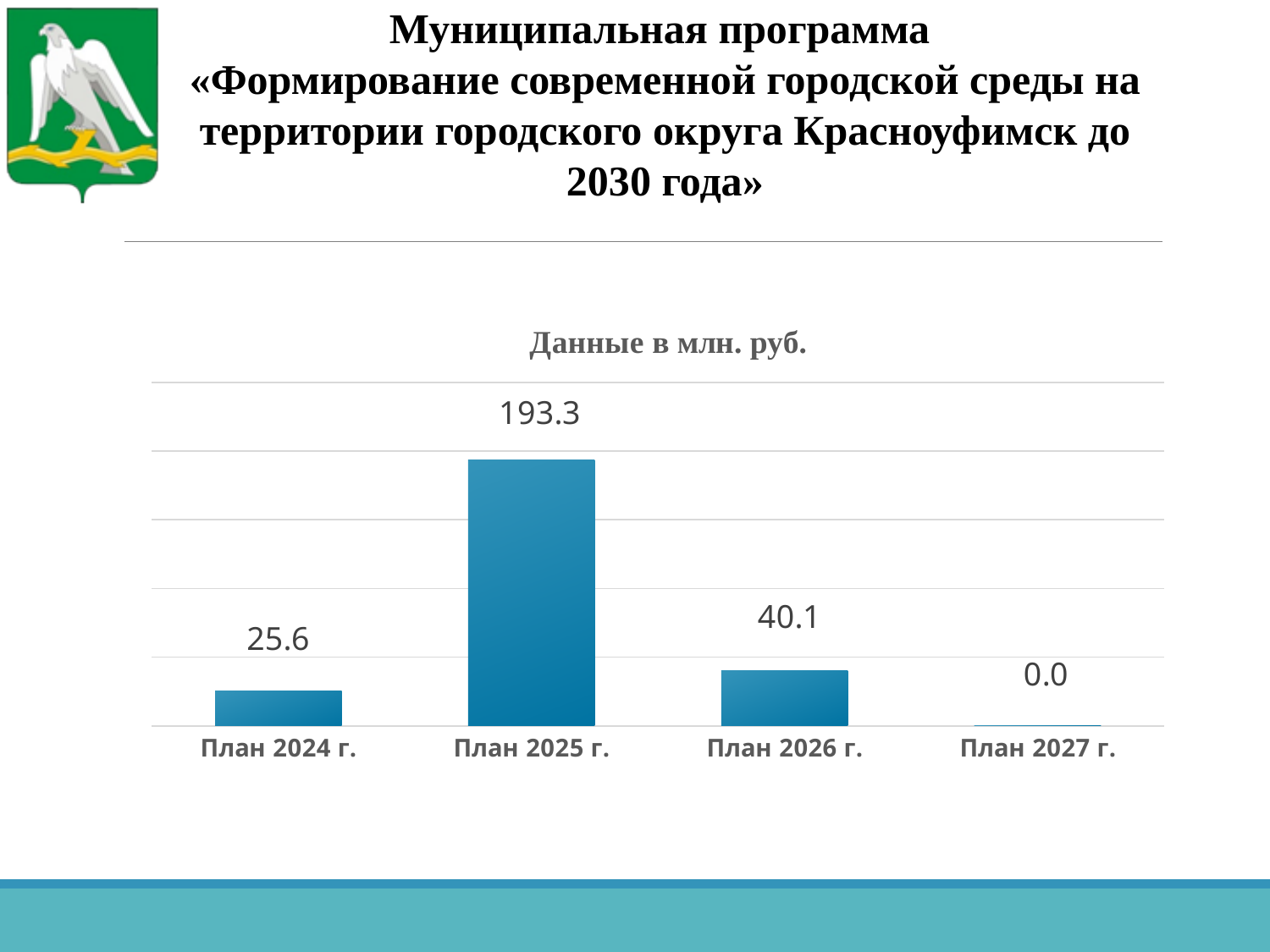
What is the difference between the values for План 2025 г. and План 2026 г.? 153.2 What is the value for План 2025 г.? 193.3 What is the value for План 2027 г.? 0.0 What is the value for План 2024 г.? 25.6 What kind of chart is shown on the slide? bar chart Which category has the lowest value? План 2027 г. How many categories are shown on the x axis? 4 What is the value for План 2026 г.? 40.1 Which is larger, the value for План 2024 г. or План 2026 г.? План 2026 г. Which category has the highest value? План 2025 г. What is the title of the chart? Данные в млн. руб. What is the difference between the values for План 2026 г. and План 2024 г.? 14.5